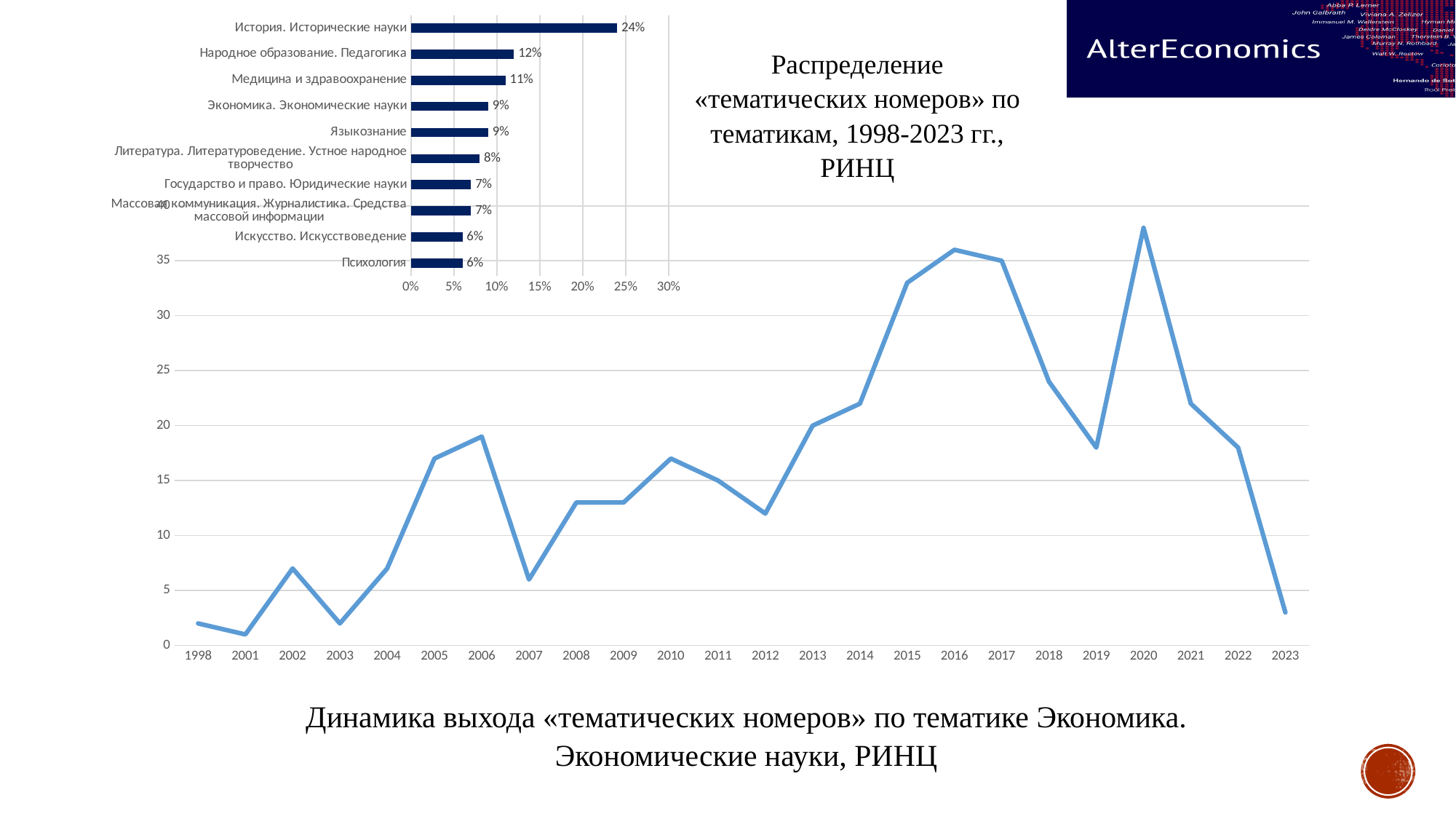
In the line chart at the bottom, which year has the highest value? 2020 In the line chart at the bottom, is the value for 2015 greater or less than 30? greater In the line chart at the bottom, how many years are plotted on the x axis? 24 In the bar chart at the top left, which category has the highest value? История. Исторические науки In the line chart at the bottom, which year has the lowest value? 2001 How many categories are shown in the bar chart at the top left? 10 In the bar chart at the top left, which is larger: Экономика. Экономические науки or Искусство. Искусствоведение? Экономика. Экономические науки In the bar chart at the top left, what is the value for Медицина и здравоохранение? 11% In the line chart at the bottom, is the value for 2023 greater or less than 5? less In the bar chart at the top left, what is the difference between Народное образование. Педагогика and Психология? 6% In the bar chart at the top left, what is the value for История. Исторические науки? 24% What kind of chart is the chart at the bottom of the slide? line chart